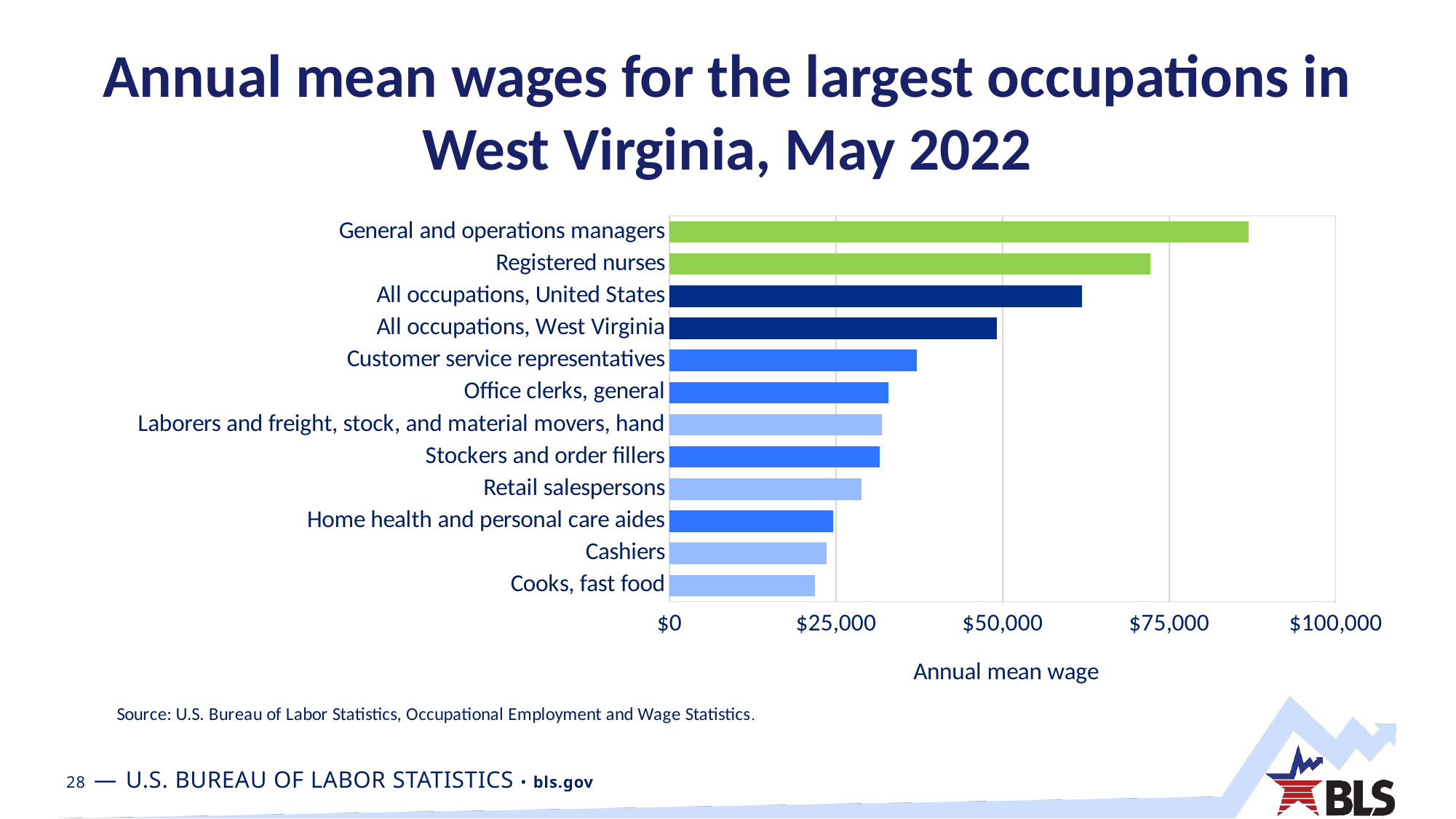
Which has a higher annual mean wage: Registered nurses or All occupations, United States? Registered nurses Which category has the lowest annual mean wage? Cooks, fast food How many occupation categories are plotted in the chart? 12 Is the annual mean wage for Retail salespersons greater or less than $25,000? greater Which has a higher annual mean wage: Customer service representatives or Office clerks, general? Customer service representatives What is the label on the horizontal axis of the chart? Annual mean wage Which category has the highest annual mean wage? General and operations managers Is the annual mean wage for Cooks, fast food greater or less than $25,000? less Is the annual mean wage for General and operations managers greater or less than $75,000? greater What kind of chart is shown on the slide? bar chart